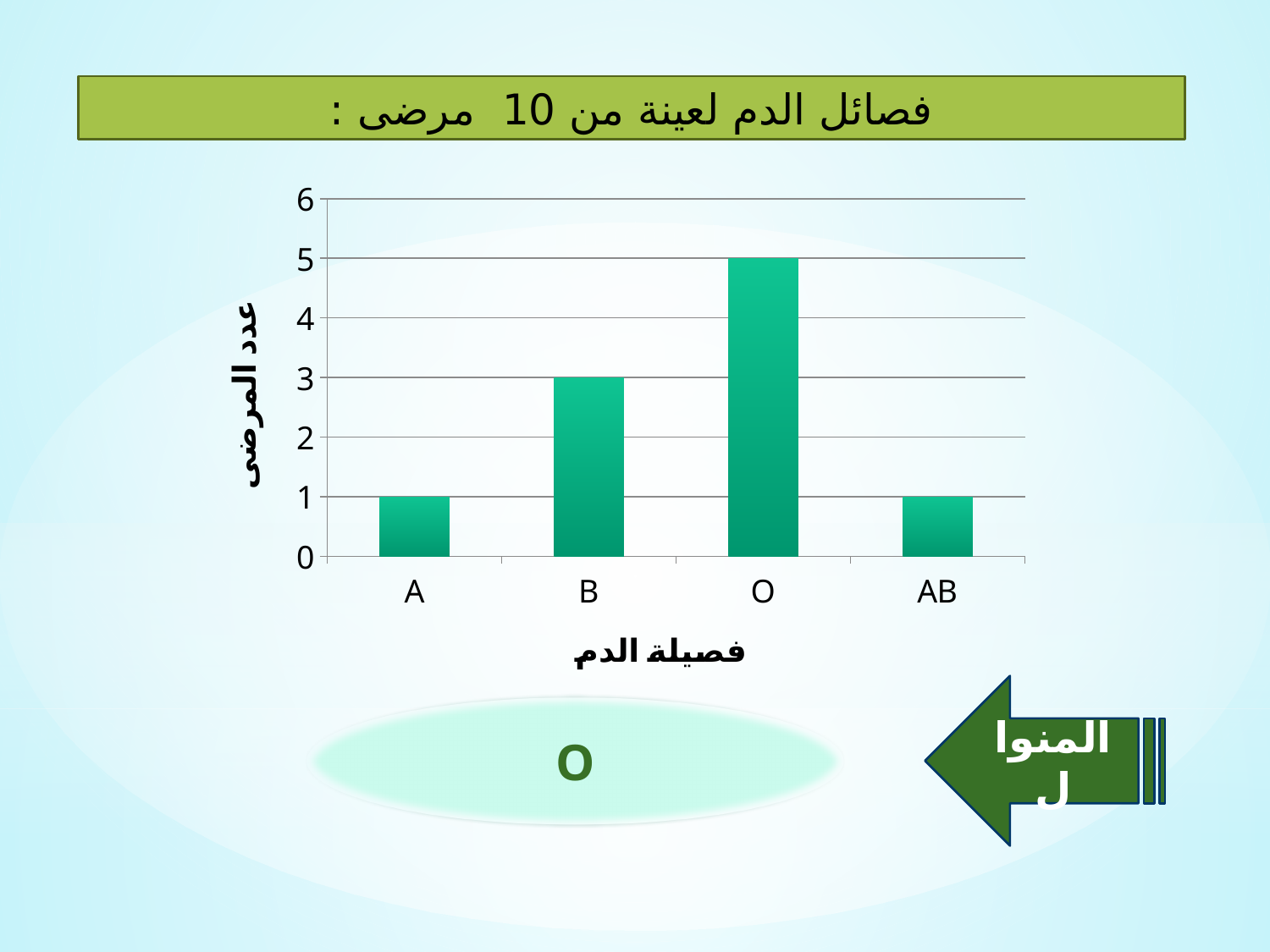
What is the difference between the number of patients with blood type O and blood type B? 2 What is the number of patients for blood type B? 3 What is the number of patients for blood type O? 5 How many blood type categories are shown on the x axis? 4 What is the label on the y axis of the chart? عدد المرضى Which has more patients, blood type B or blood type AB? B Which blood type has the highest number of patients? O Is the value for blood type O greater or less than 4? greater What kind of chart is shown on the slide? bar chart What is the label on the x axis of the chart? فصيلة الدم What is the number of patients for blood type A? 1 What is the total number of patients across all four blood types? 10